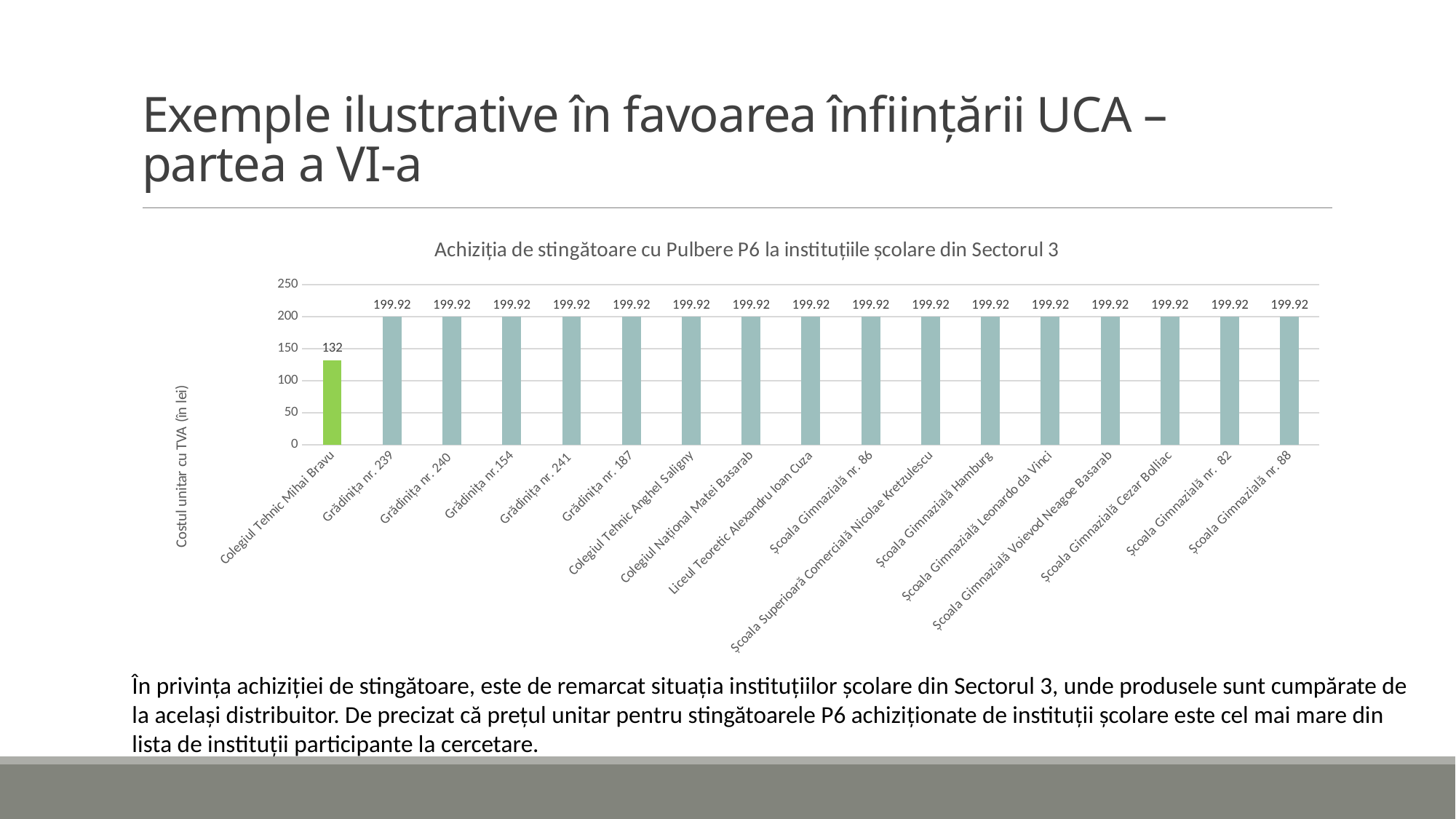
What is the value for Grădinița nr. 239? 199.92 What is the value for Școala Gimnazială nr. 88? 199.92 What is the title of the chart? Achiziția de stingătoare cu Pulbere P6 la instituțiile școlare din Sectorul 3 What kind of chart is shown on the slide? bar chart Is the value for Colegiul Tehnic Mihai Bravu greater or less than 150? less How many institutions are shown on the chart? 17 Which institution has the lowest value? Colegiul Tehnic Mihai Bravu What is the value for Colegiul Tehnic Mihai Bravu? 132 Is the value for Liceul Teoretic Alexandru Ioan Cuza greater or less than 150? greater What is the difference between the value for Grădinița nr. 240 and the value for Colegiul Tehnic Mihai Bravu? 67.92 What is the value for Școala Gimnazială Hamburg? 199.92 Which is larger, the value for Colegiul Tehnic Mihai Bravu or the value for Colegiul Tehnic Anghel Saligny? Colegiul Tehnic Anghel Saligny